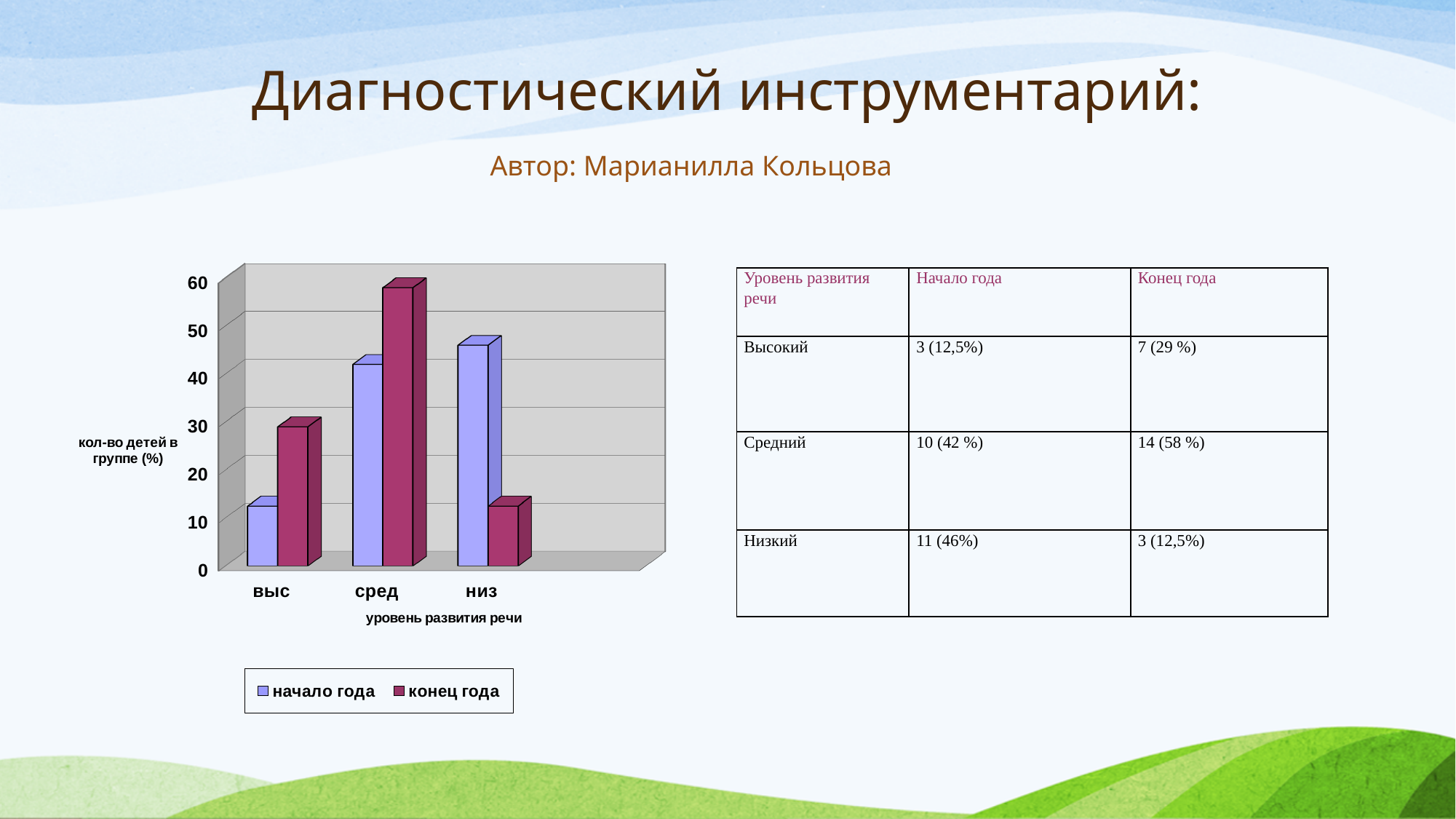
Do the values for the series начало года rise or fall from выс to низ along the x axis? rise Is the value for выс in the series начало года greater or less than 20? less Which category has the highest value for the series конец года? сред Which category has the lowest value for the series начало года? выс What kind of chart is shown on the slide? bar chart Is the value for сред in the series конец года greater or less than 50? greater For the category выс, which series has the larger value: начало года or конец года? конец года Is the value for низ in the series начало года greater or less than 40? greater What is the title of the vertical axis of the chart? кол-во детей в группе (%) How many series does the chart legend list? 2 How many categories are shown on the x axis of the chart? 3 For the category низ, which series has the larger value: начало года or конец года? начало года